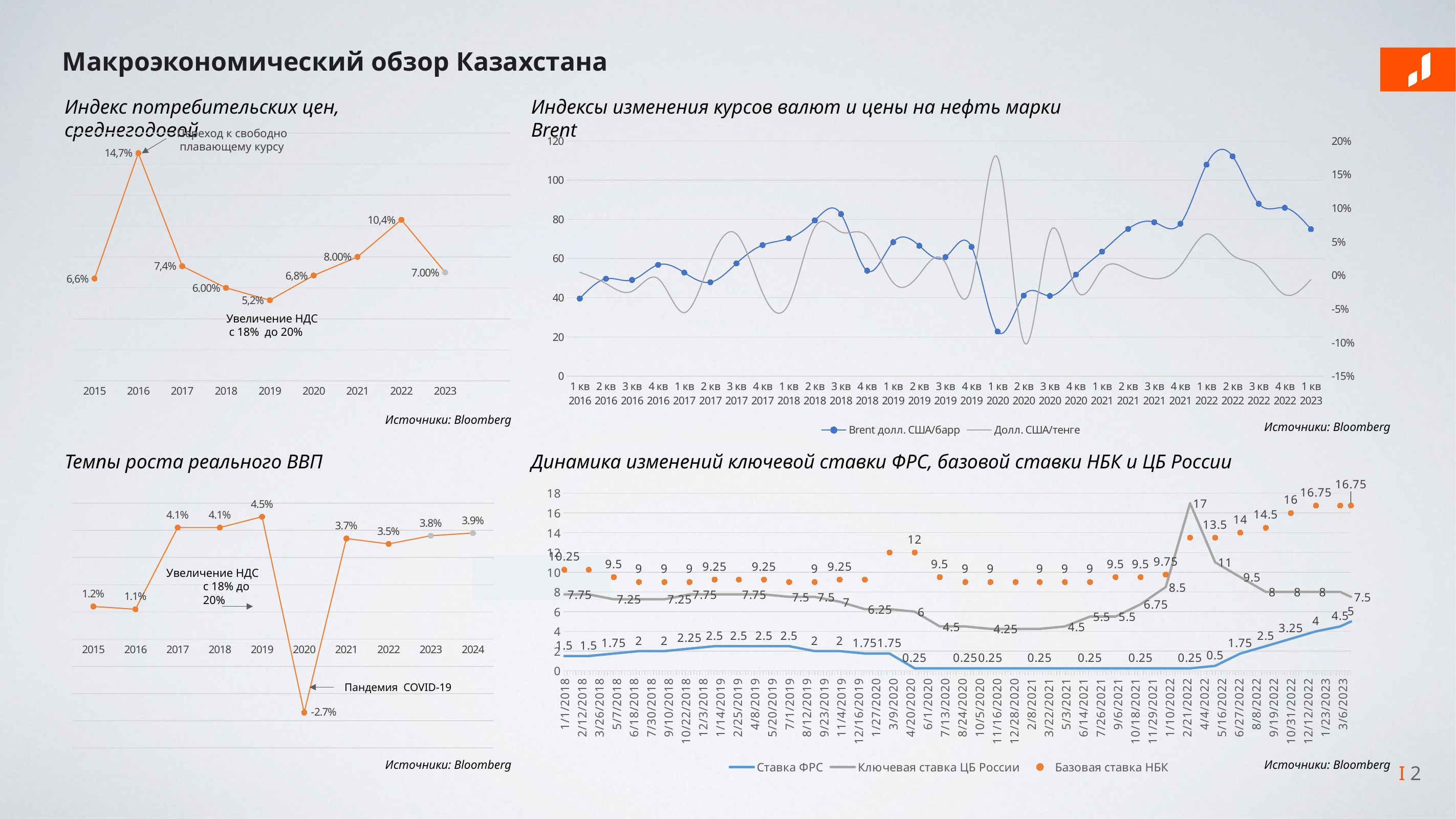
In the chart 'Динамика изменений ключевой ставки ФРС, базовой ставки НБК и ЦБ России', what is the value of Базовая ставка НБК at 3/6/2023? 16.75 In the chart 'Индекс потребительских цен, среднегодовой', what is the value for 2022? 10,4% In the chart 'Темпы роста реального ВВП', which year has the lowest value? 2020 In the chart 'Индекс потребительских цен, среднегодовой', what is the value for 2016? 14,7% How many years are shown on the x axis of the chart 'Темпы роста реального ВВП'? 10 In the chart 'Индекс потребительских цен, среднегодовой', which year has the lowest value? 2019 In the chart 'Темпы роста реального ВВП', what is the value for 2020? -2.7% In the chart 'Индекс потребительских цен, среднегодовой', what is the difference between the 2016 and 2015 values? 8,1 percentage points How many series does the legend of the chart 'Индексы изменения курсов валют и цены на нефть марки Brent' list? 2 In the chart 'Темпы роста реального ВВП', which year has the highest value? 2019 In the chart 'Индексы изменения курсов валют и цены на нефть марки Brent', is the Brent value for 1 кв 2020 greater or less than 40? less In the chart 'Динамика изменений ключевой ставки ФРС, базовой ставки НБК и ЦБ России', which is larger at 3/6/2023: Базовая ставка НБК or Ключевая ставка ЦБ России? Базовая ставка НБК